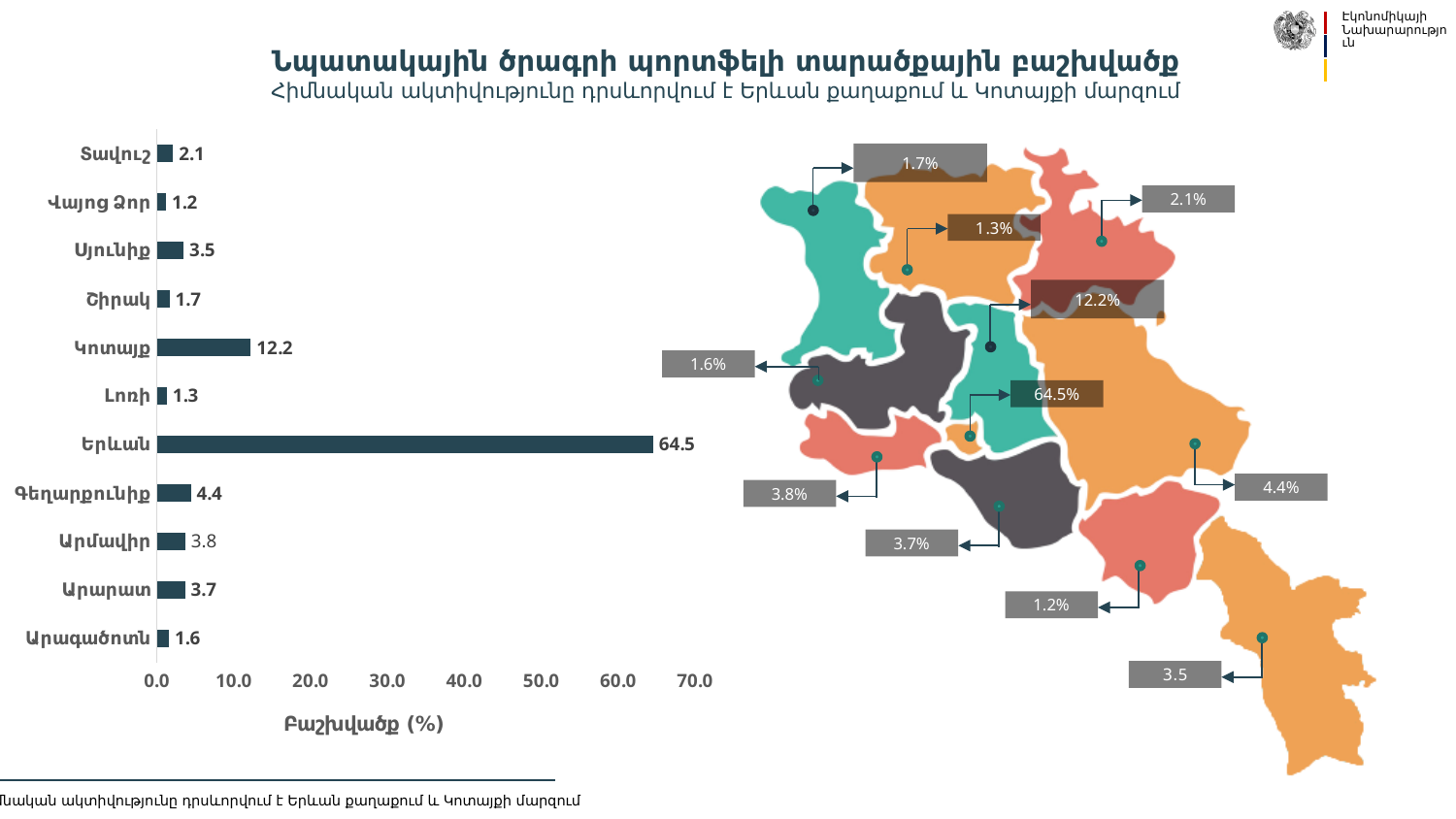
What is the difference between the values for Գեղարքունիք and Արարատ? 0.7 What is the value for Գեղարքունիք in the bar chart? 4.4 Which is larger, the value for Սյունիք or the value for Արմավիր? Արմավիր What kind of chart is shown on the left of the slide? bar chart What is the value for Երևան in the bar chart? 64.5 Which category has the highest value in the bar chart? Երևան What is the x-axis title of the bar chart? Բաշխվածք (%) How many categories are shown in the bar chart? 11 What is the value for Կոտայք in the bar chart? 12.2 What is the difference between the values for Երևան and Կոտայք? 52.3 Is the value for Կոտայք greater or less than 10.0? greater Which category has the lowest value in the bar chart? Վայոց Ձոր